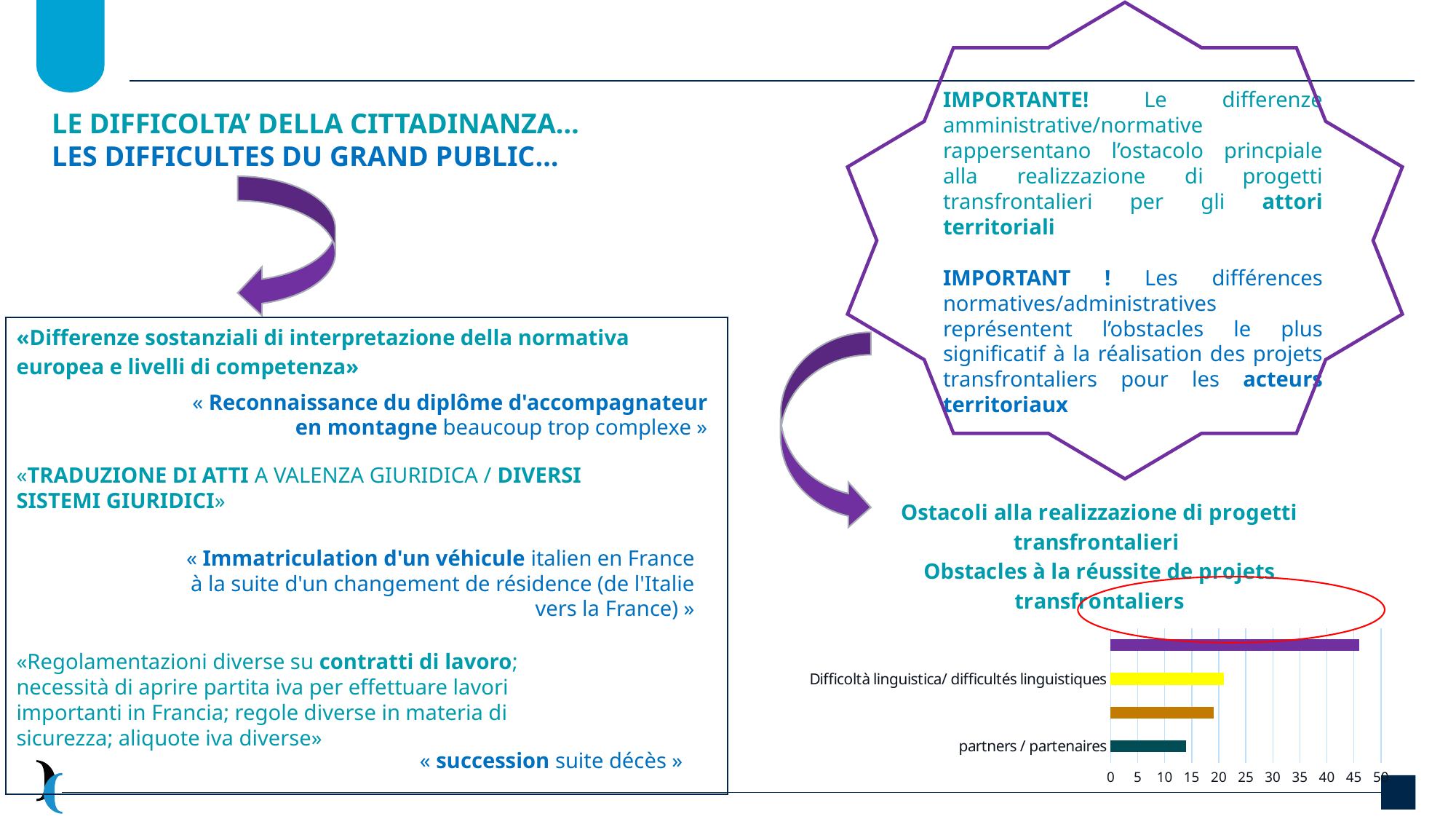
Which is larger in the bar chart: 'Difficoltà linguistica/ difficultés linguistiques' or 'partners / partenaires'? Difficoltà linguistica/ difficultés linguistiques Is the value for 'Difficoltà linguistica/ difficultés linguistiques' greater or less than 25? less What kind of chart is shown under the title 'Ostacoli alla realizzazione di progetti transfrontalieri'? bar chart What is the highest value shown on the horizontal axis of the bar chart? 50 How many bars are plotted in the chart on the slide? 4 Is the value for 'partners / partenaires' greater or less than 20? less Is the value for 'partners / partenaires' greater or less than 10? greater What colour is the bar for 'Difficoltà linguistica/ difficultés linguistiques'? yellow Which category has the lowest value in the bar chart? partners / partenaires